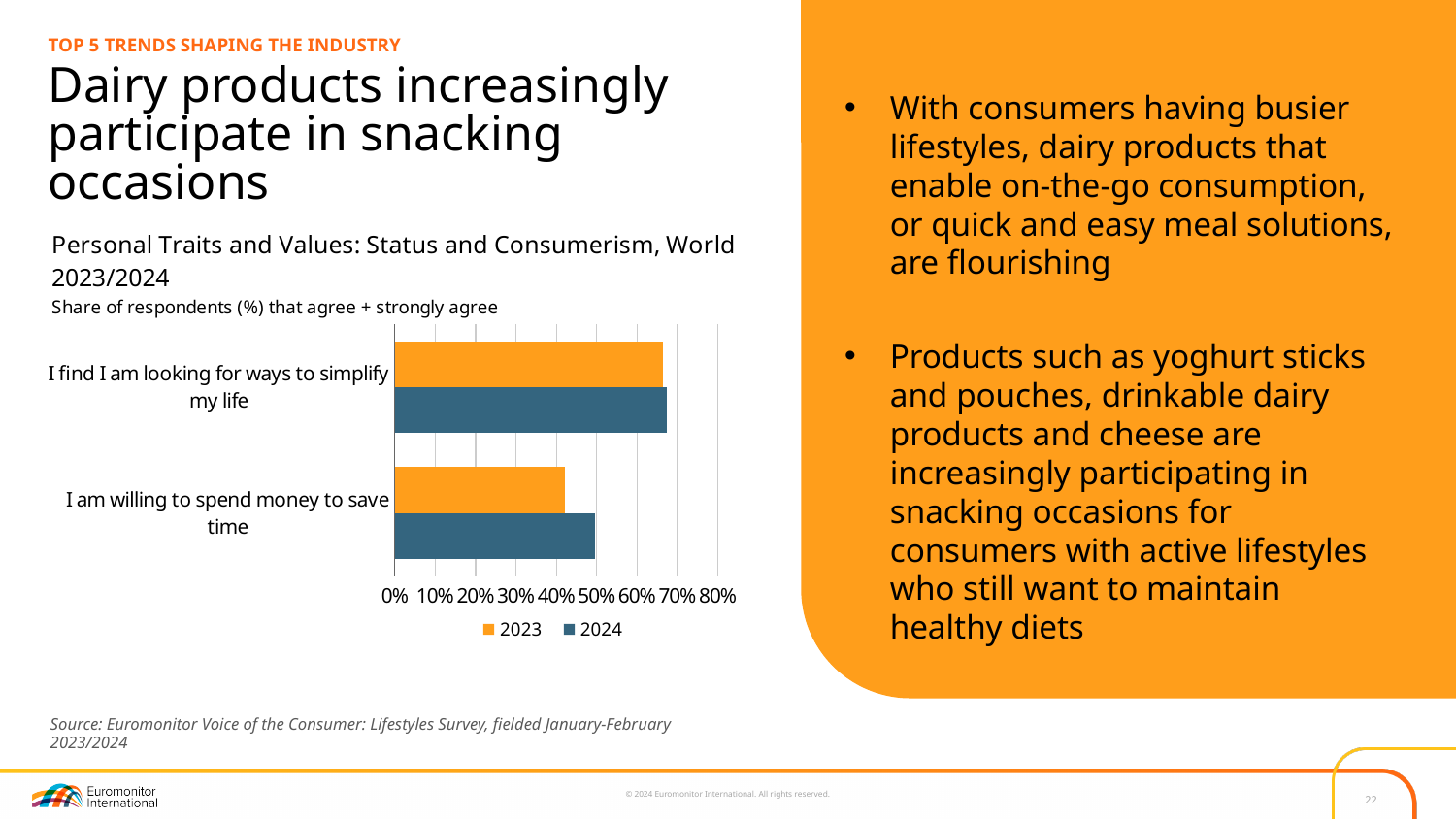
What kind of chart is shown on the slide? bar chart Is the 2023 value for "I find I am looking for ways to simplify my life" greater or less than 60%? greater Which years are shown in the chart legend? 2023 and 2024 Is the 2024 value for "I am willing to spend money to save time" greater or less than 40%? greater Is the 2023 value for "I am willing to spend money to save time" greater or less than 50%? less For 2024, which statement has the lower share of respondents agreeing? I am willing to spend money to save time For "I am willing to spend money to save time", which year has the larger value, 2023 or 2024? 2024 How many statement categories are plotted on the chart? 2 How many series does the chart legend list? 2 What is the subtitle describing the measure plotted on the chart? Share of respondents (%) that agree + strongly agree For 2023, which statement has the higher share of respondents agreeing? I find I am looking for ways to simplify my life